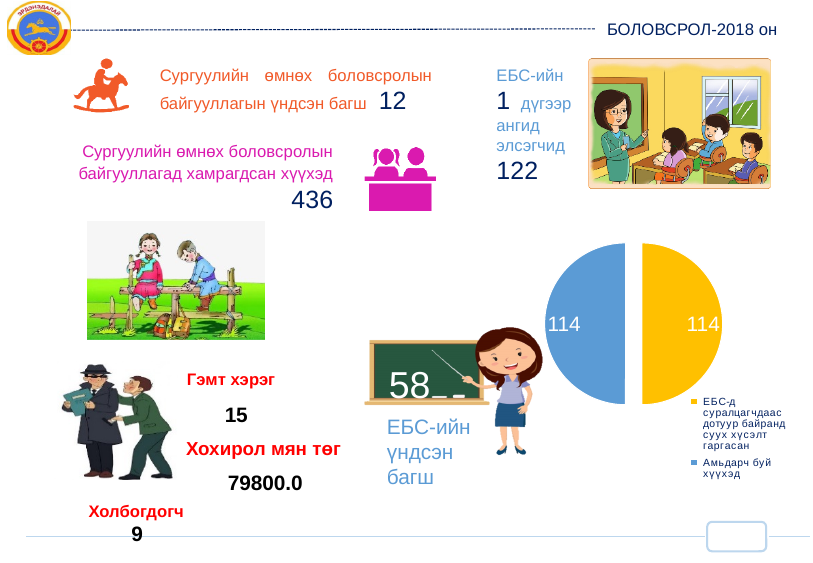
What is the total of the two slices in the pie chart? 228 How many entries does the pie chart's legend list? 2 Which colour is used for the "ЕБС-д суралцагчдаас дотуур байранд суух хүсэлт гаргасан" slice in the pie chart? yellow What is the difference between the two slice values in the pie chart? 0 What is the value of the slice labelled "Амьдарч буй хүүхэд" in the pie chart? 114 What is the value of the slice labelled "ЕБС-д суралцагчдаас дотуур байранд суух хүсэлт гаргасан" in the pie chart? 114 How many slices does the pie chart have? 2 What kind of chart is shown on the slide? pie chart What share of the pie does the "Амьдарч буй хүүхэд" slice represent? 50% Which colour is used for the "Амьдарч буй хүүхэд" slice in the pie chart? blue